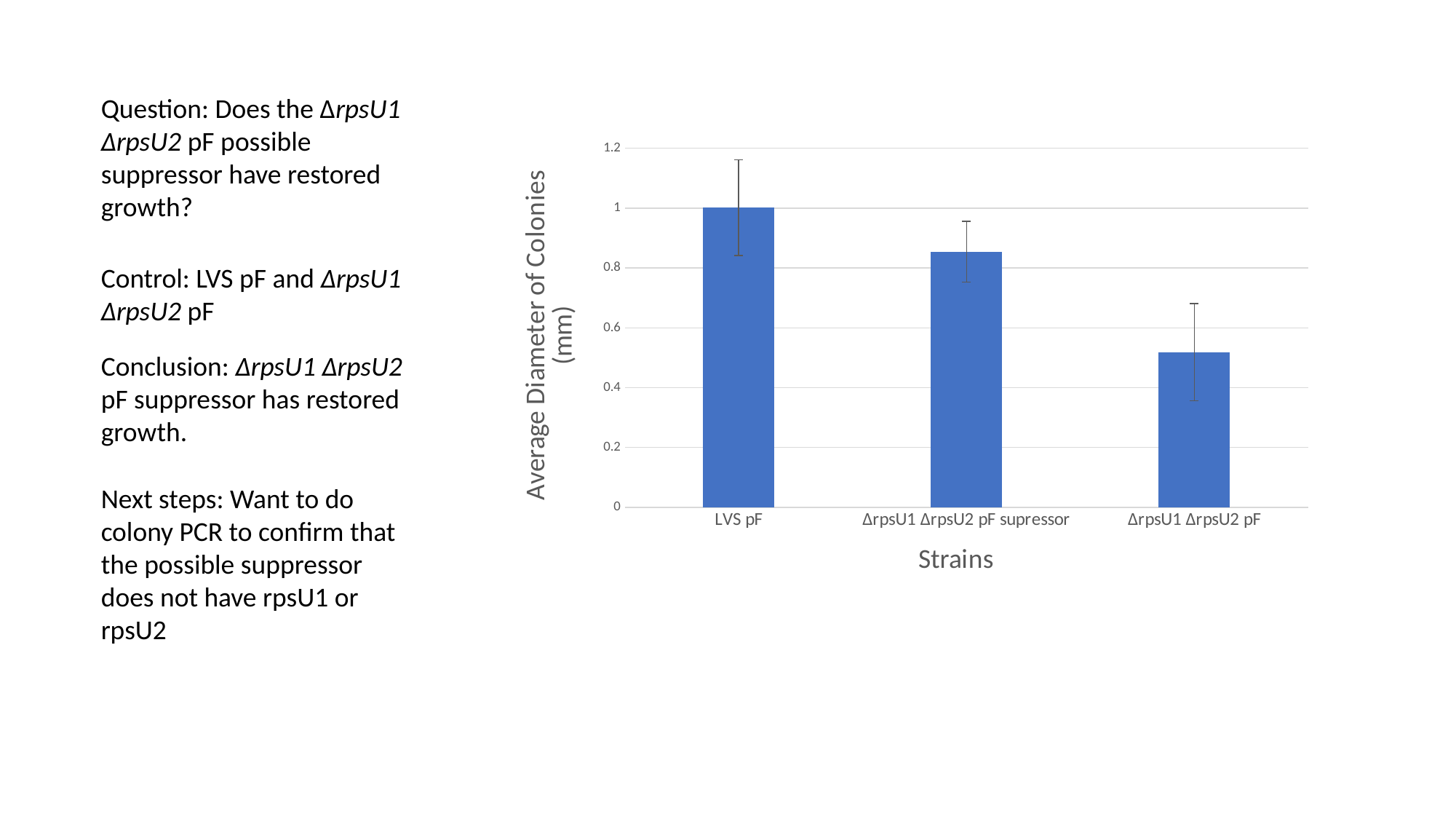
Which has a larger average colony diameter, ΔrpsU1 ΔrpsU2 pF supressor or ΔrpsU1 ΔrpsU2 pF? ΔrpsU1 ΔrpsU2 pF supressor What is the average diameter of colonies for LVS pF? 1 How many strains are plotted on the chart? 3 Do the bar values rise or fall from left to right across the strains? fall Is the value for ΔrpsU1 ΔrpsU2 pF greater or less than 0.4? greater What kind of chart is shown on the slide? bar chart What is the label of the horizontal axis of the chart? Strains What is the label of the vertical axis of the chart? Average Diameter of Colonies (mm) Is the value for ΔrpsU1 ΔrpsU2 pF supressor greater or less than 0.8? greater Which strain has the lowest average colony diameter? ΔrpsU1 ΔrpsU2 pF Is the value for ΔrpsU1 ΔrpsU2 pF greater or less than 0.6? less Which strain has the highest average colony diameter? LVS pF